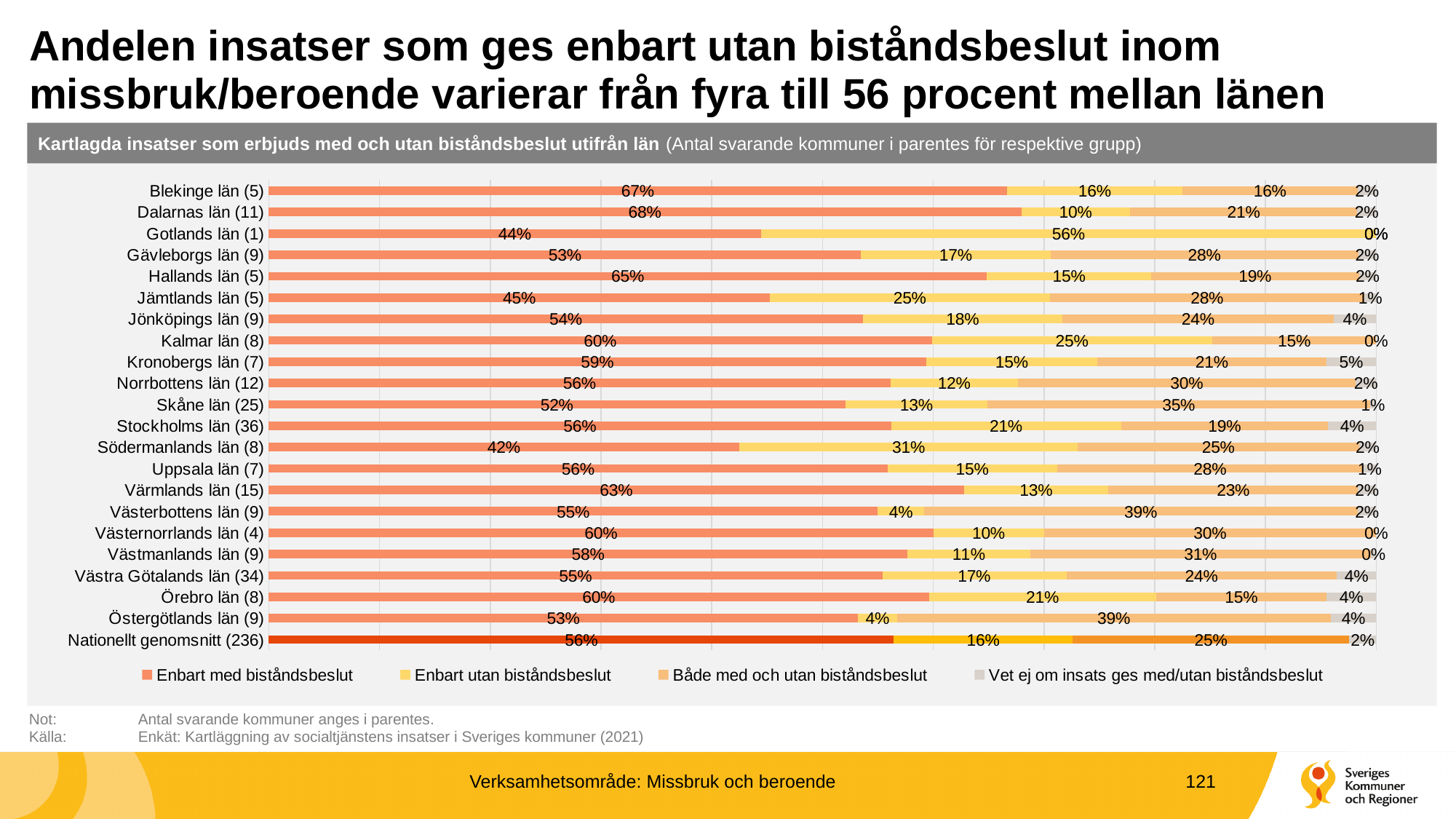
What is the value of 'Enbart utan biståndsbeslut' for Gotlands län (1)? 56% What is the value of 'Enbart med biståndsbeslut' for Dalarnas län (11)? 68% What is the difference between the 'Enbart utan biståndsbeslut' values for Södermanlands län (8) and Nationellt genomsnitt (236)? 15% What kind of chart is shown on the slide? Stacked bar chart How many series does the legend list? 4 Which category has the highest value for 'Enbart med biståndsbeslut'? Dalarnas län (11) Which category has the lowest value for 'Enbart med biståndsbeslut'? Södermanlands län (8) Which has a larger 'Enbart med biståndsbeslut' value, Blekinge län (5) or Jämtlands län (5)? Blekinge län (5) What is the value of 'Vet ej om insats ges med/utan biståndsbeslut' for Nationellt genomsnitt (236)? 2% Which category has the highest value for 'Vet ej om insats ges med/utan biståndsbeslut'? Kronobergs län (7) How many bars (categories) are plotted in the chart, including the national average? 22 What is the value of 'Både med och utan biståndsbeslut' for Skåne län (25)? 35%